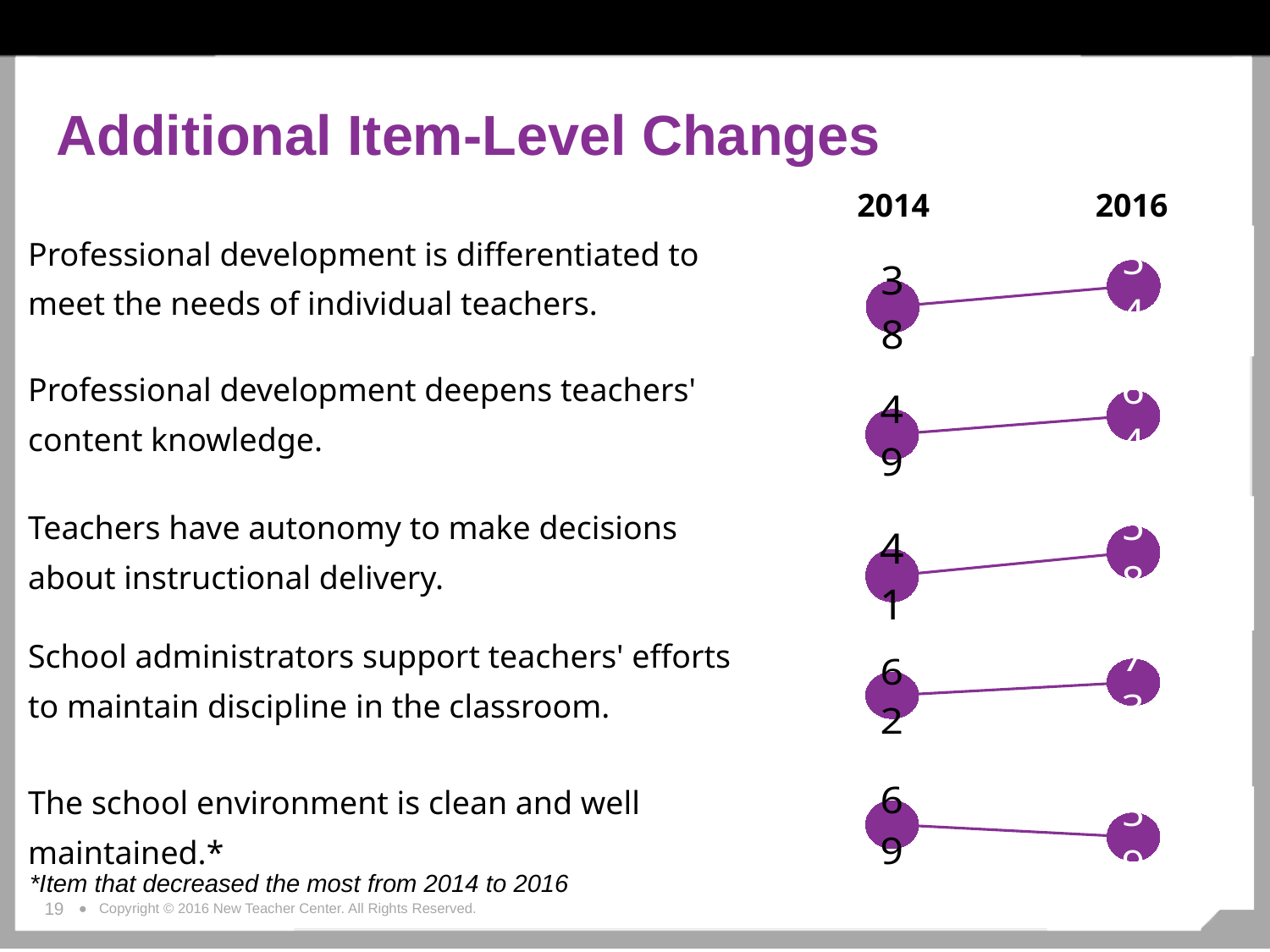
In the chart for 'The school environment is clean and well maintained', what is the 2014 value? 69 Across the five charts, which item has the highest 2014 value? The school environment is clean and well maintained. In the chart for 'Professional development is differentiated to meet the needs of individual teachers', what is the 2014 value? 38 In the chart for 'School administrators support teachers' efforts to maintain discipline in the classroom', what is the 2014 value? 62 What is the difference between the 2014 values for 'School administrators support teachers' efforts to maintain discipline in the classroom' and 'Teachers have autonomy to make decisions about instructional delivery'? 21 Across the five charts, which item has the lowest 2014 value? Professional development is differentiated to meet the needs of individual teachers. In the chart for 'Professional development is differentiated to meet the needs of individual teachers', does the value rise or fall from 2014 to 2016? rise In the chart for 'Teachers have autonomy to make decisions about instructional delivery', what is the 2014 value? 41 Which two years are compared in the charts? 2014 and 2016 In the chart for 'The school environment is clean and well maintained', does the value rise or fall from 2014 to 2016? fall In the chart for 'Professional development deepens teachers' content knowledge', what is the 2014 value? 49 How many items (charts) are shown on the slide? 5